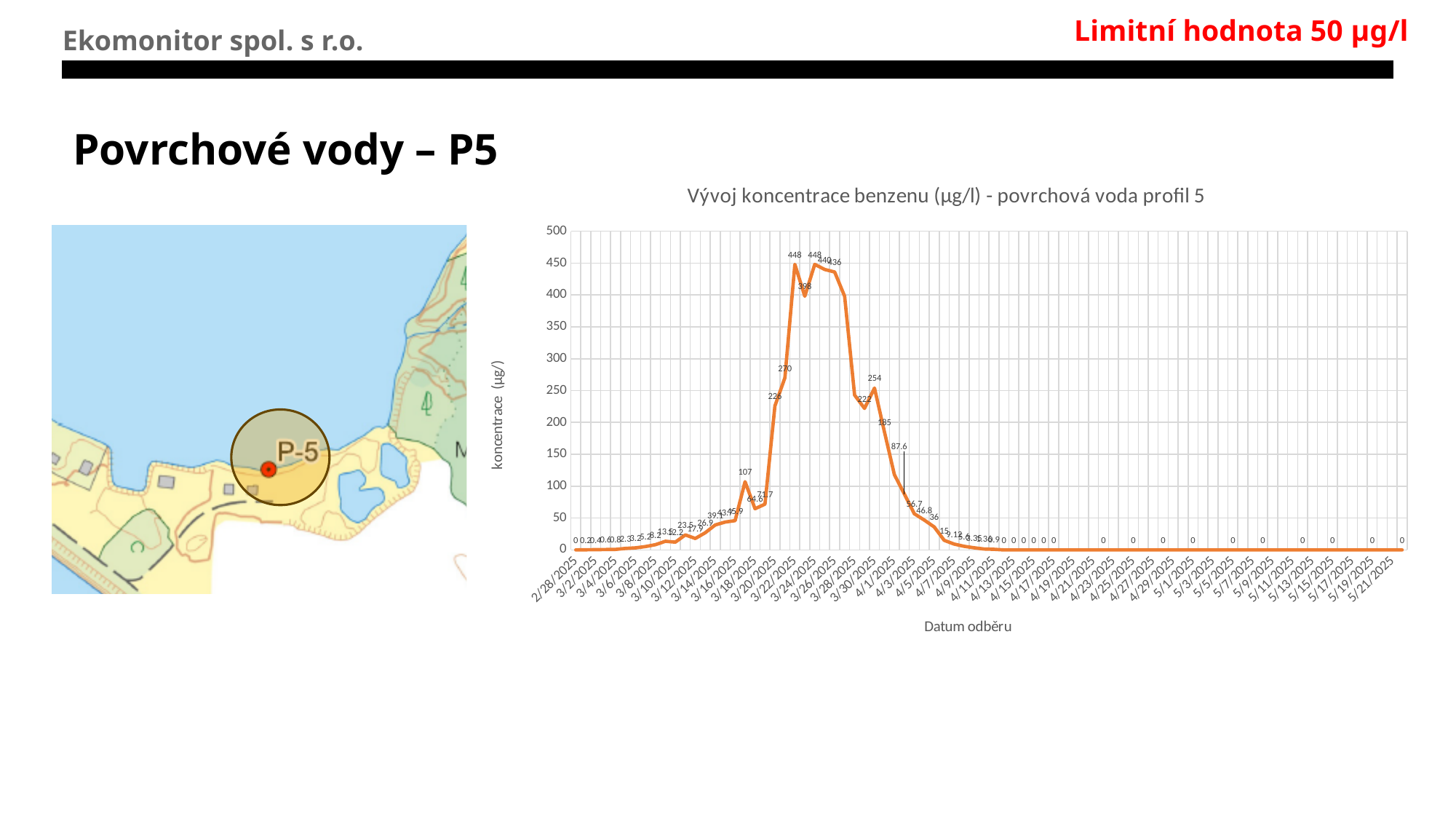
What kind of chart is shown on the slide? line chart Do the values rise or fall between 3/26/2025 and 4/9/2025? fall What is the value plotted for 5/21/2025? 0 Is the value for 3/8/2025 greater or less than 50? less Is the value for 3/24/2025 greater or less than 300? greater By how much does the peak value of 448 exceed the dip value of 398 labelled between the two 448 peaks? 50 What is the label of the x axis of the chart? Datum odběru What is the value plotted for 2/28/2025? 0 What is the highest value labelled on the chart? 448 Is the value for 4/21/2025 greater or less than 50? less Which is larger, the value on 3/24/2025 or the value on 4/1/2025? 3/24/2025 What is the title of the chart? Vývoj koncentrace benzenu (µg/l) - povrchová voda profil 5